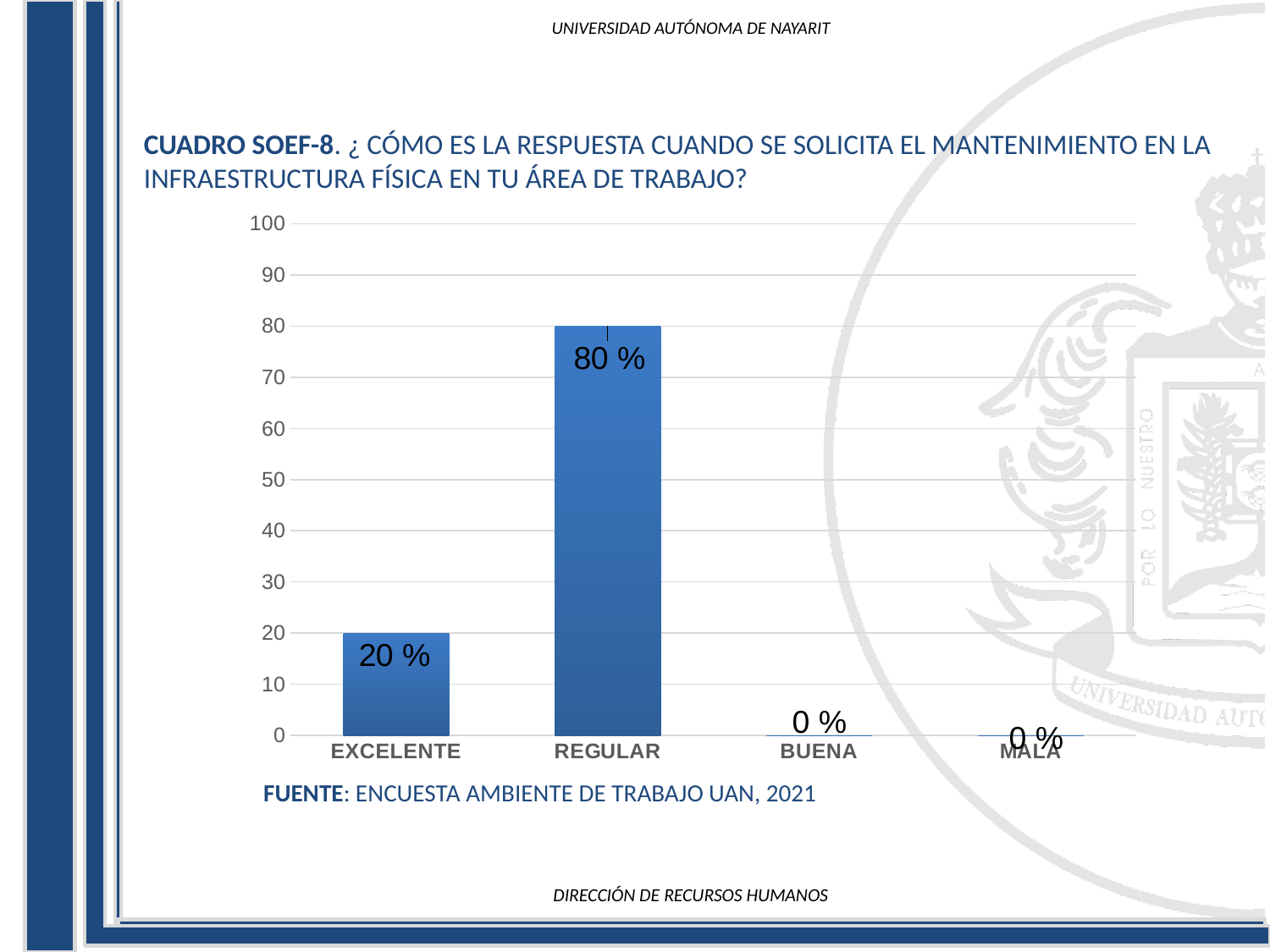
What is the source cited below the chart? ENCUESTA AMBIENTE DE TRABAJO UAN, 2021 Is the value for REGULAR greater or less than 50? greater Is the value for EXCELENTE greater or less than 30? less What is the value for EXCELENTE? 20 % Which category has the highest value? REGULAR What is the value for BUENA? 0 % What is the value for MALA? 0 % What is the difference between the values for REGULAR and EXCELENTE? 60 % How many categories are shown on the x axis? 4 What kind of chart is shown on the slide? bar chart Which is larger, the value for EXCELENTE or the value for REGULAR? REGULAR What is the value for REGULAR? 80 %